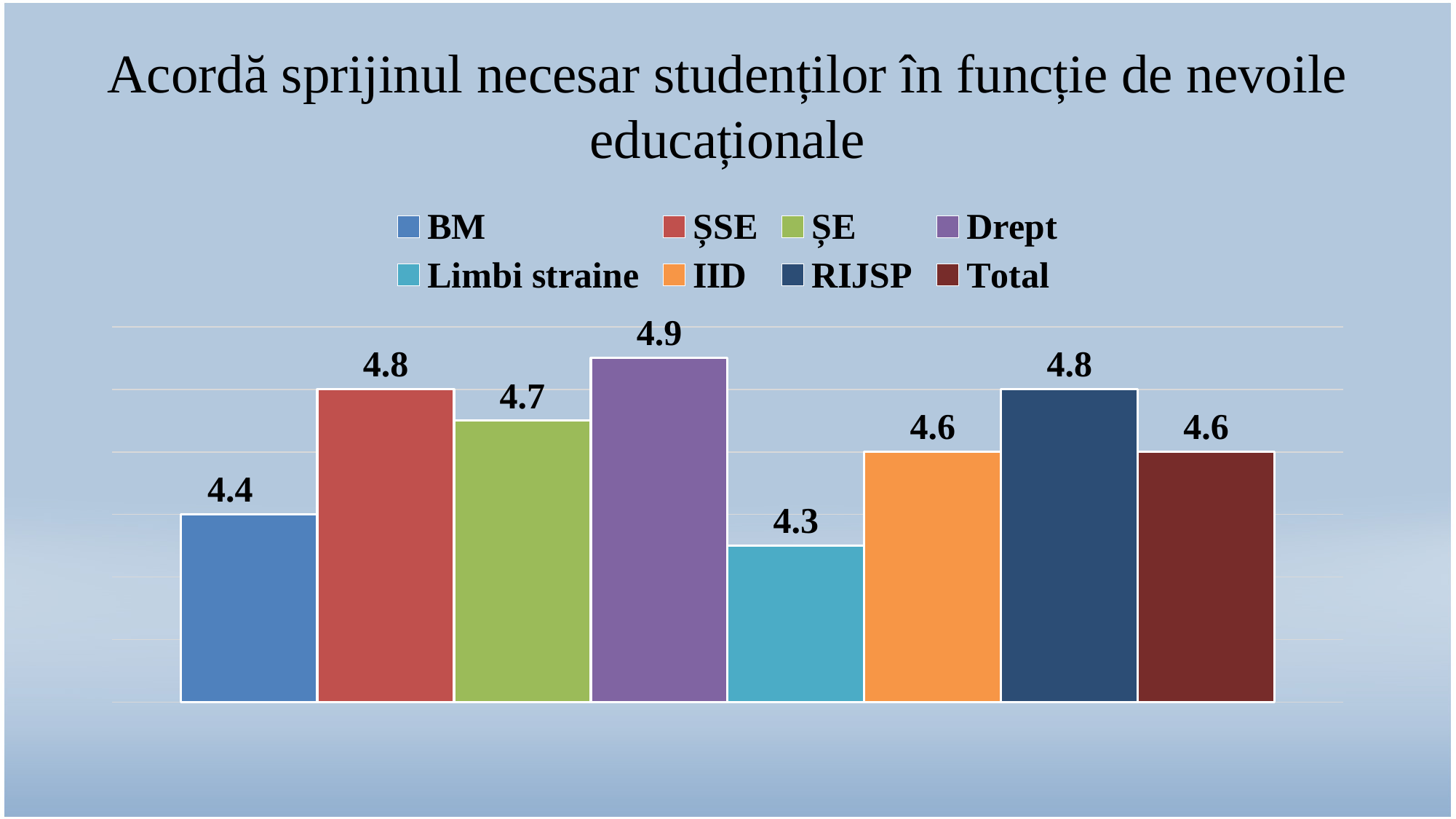
What colour is the bar for RIJSP? Dark blue What is the value for Limbi straine? 4.3 Which is larger, the value for ȘE or the value for IID? ȘE What is the value for Total? 4.6 How many series does the legend list? 8 Which series has the highest value? Drept Which series has the lowest value? Limbi straine What is the difference between the values for Drept and Limbi straine? 0.6 What kind of chart is shown on the slide? Bar chart What is the value for Drept? 4.9 What is the value for BM? 4.4 What is the difference between the values for ȘSE and BM? 0.4